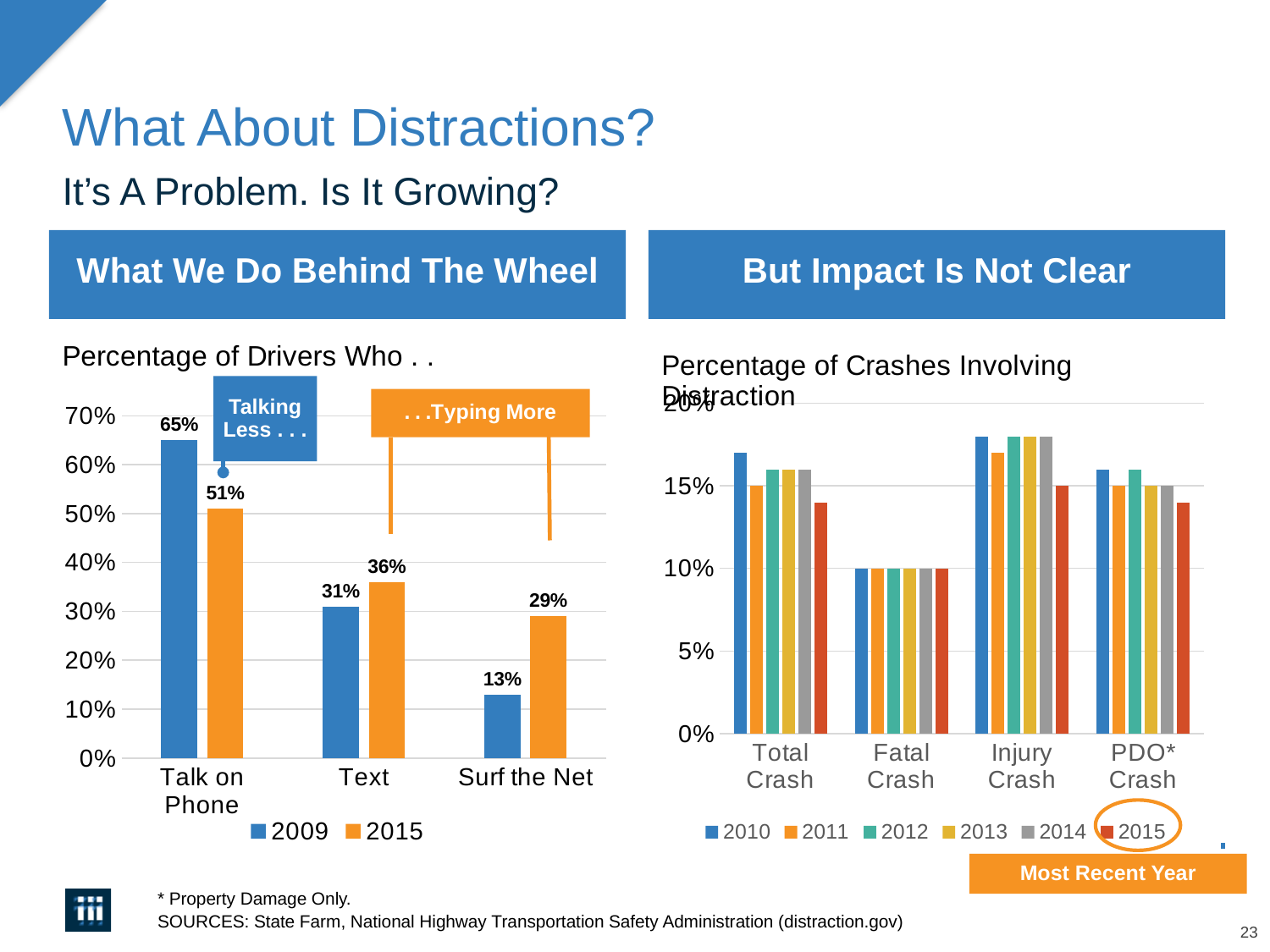
What kind of chart is the right chart (Percentage of Crashes Involving Distraction)? Bar chart In the left chart (Percentage of Drivers Who . .), which category has the highest 2009 value? Talk on Phone In the left chart (Percentage of Drivers Who . .), which is larger for Talk on Phone: the 2009 value or the 2015 value? 2009 In the left chart (Percentage of Drivers Who . .), which category has the lowest 2015 value? Surf the Net In the left chart (Percentage of Drivers Who . .), what is the 2015 value for Surf the Net? 29% In the left chart (Percentage of Drivers Who . .), what is the difference between the 2015 and 2009 values for Text? 5% In the left chart (Percentage of Drivers Who . .), how many series does the legend list? 2 In the left chart (Percentage of Drivers Who . .), what is the 2009 value for Talk on Phone? 65% In the right chart (Percentage of Crashes Involving Distraction), what is the 2010 value for Fatal Crash? 10% In the right chart (Percentage of Crashes Involving Distraction), how many series does the legend list? 6 In the right chart (Percentage of Crashes Involving Distraction), is the 2015 value for Total Crash greater or less than 15%? less In the right chart (Percentage of Crashes Involving Distraction), how many categories are shown on the x axis? 4